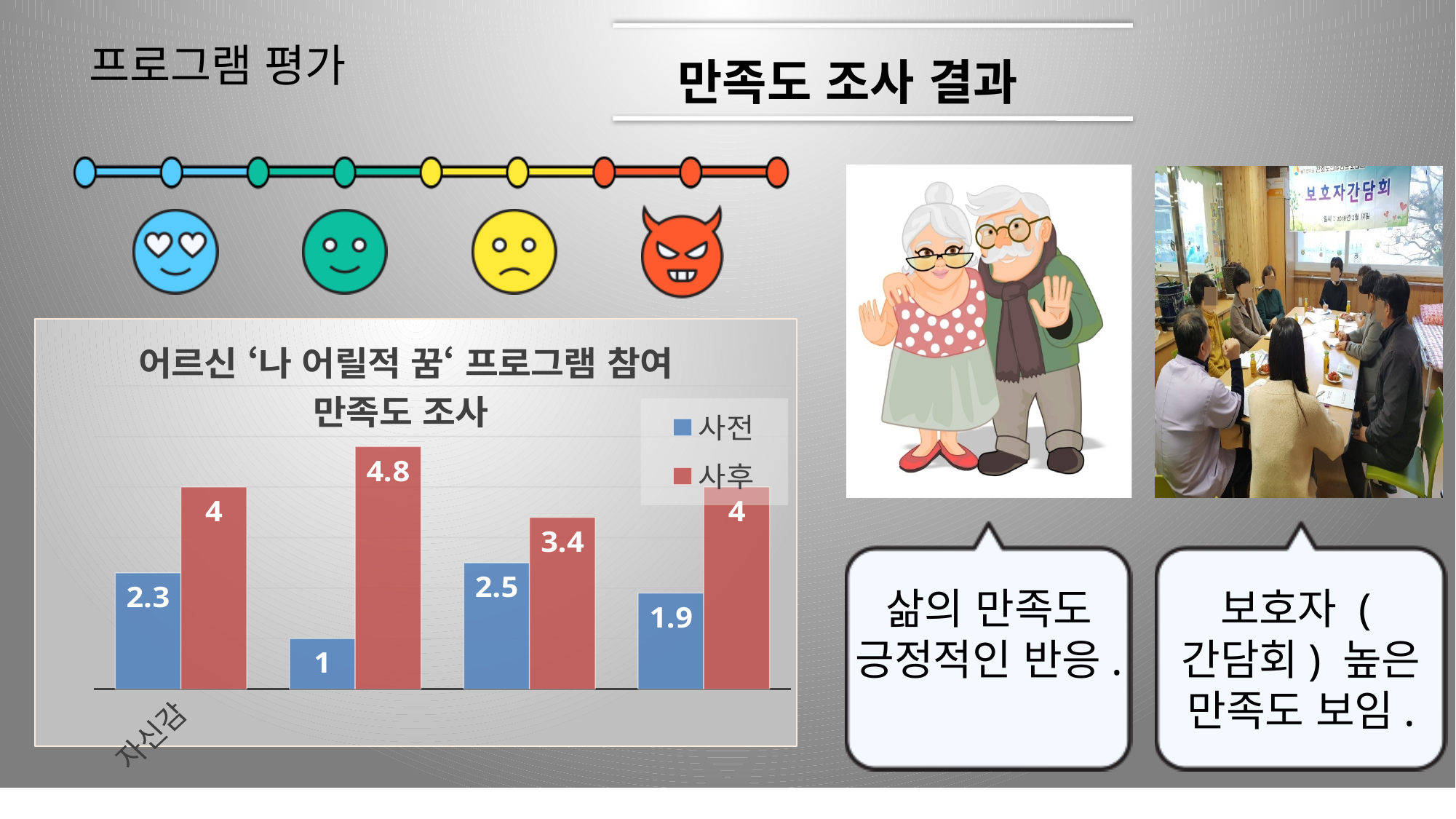
Which category group has the lowest 사전 value? the second group from the left (1) What is the 사후 value for 자신감? 4 What is the 사전 value for 자신감? 2.3 How many series does the chart legend list? 2 Which category group has the highest 사후 value? the second group from the left (4.8) How many category groups of bars are plotted in the chart? 4 What is the 사전 value for the second category group from the left? 1 What is the 사후 value for the second category group from the left? 4.8 What is the difference between the 사후 and 사전 values for 자신감? 1.7 What colour are the 사후 bars in the chart? red What kind of chart is shown on the slide? bar chart For the third category group from the left, which is larger, the 사전 value or the 사후 value? 사후